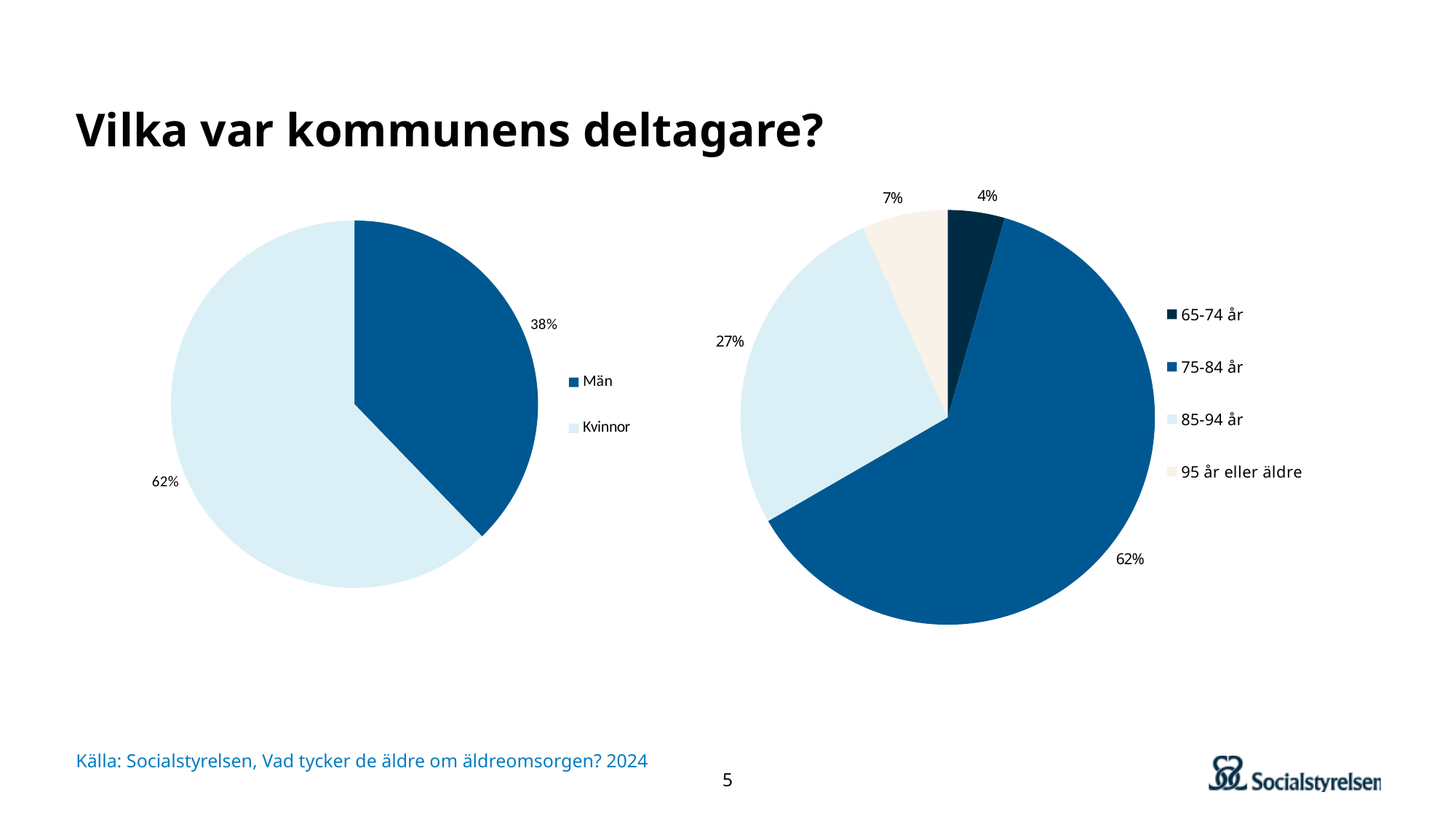
In the right pie chart, what share of participants are 75-84 år? 62% In the left pie chart, what share of participants are Kvinnor? 62% What kind of chart is the chart on the right of the slide? Pie chart In the right pie chart, what share of participants are 85-94 år? 27% In the right pie chart, what share of participants are 95 år eller äldre? 7% In the left pie chart, what share of participants are Män? 38% In the left pie chart, which group has the larger share, Män or Kvinnor? Kvinnor In the right pie chart, how many age groups are shown? 4 In the right pie chart, which age group has the largest share? 75-84 år In the left pie chart, what is the difference in percentage points between Kvinnor and Män? 24 In the right pie chart, which age group has the smallest share? 65-74 år In the left pie chart, how many categories does the legend list? 2